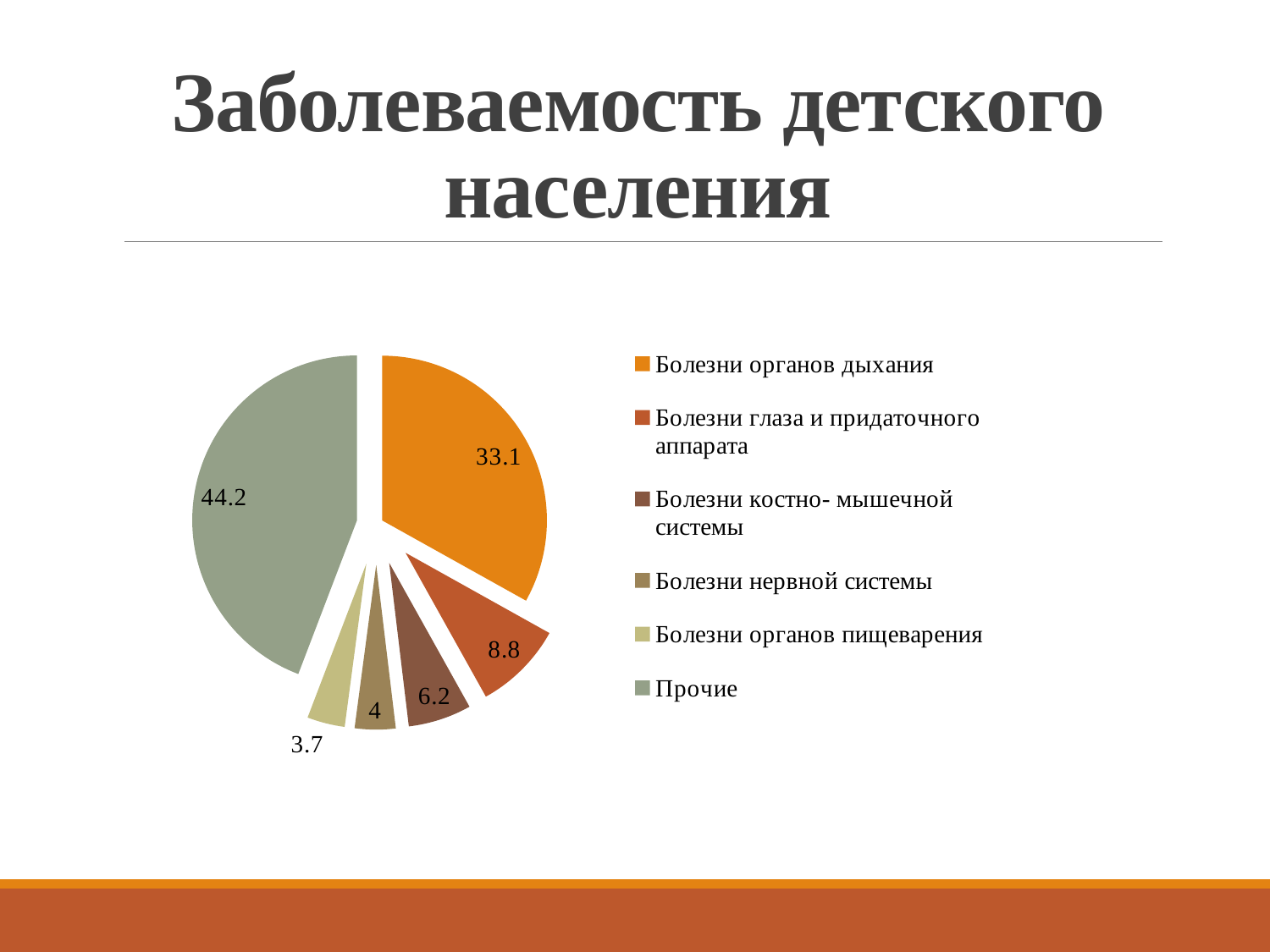
Which is larger, Болезни глаза и придаточного аппарата or Болезни костно- мышечной системы? Болезни глаза и придаточного аппарата Which category has the smallest slice? Болезни органов пищеварения What is the difference between the values for Прочие and Болезни органов дыхания? 11.1 What is the value for Болезни костно- мышечной системы? 6.2 What is the value for Болезни нервной системы? 4 What is the value for Прочие? 44.2 Which category has the largest slice? Прочие What is the value for Болезни глаза и придаточного аппарата? 8.8 What is the value for Болезни органов дыхания? 33.1 What kind of chart is shown on the slide? pie chart How many categories does the legend list? 6 What is the value for Болезни органов пищеварения? 3.7